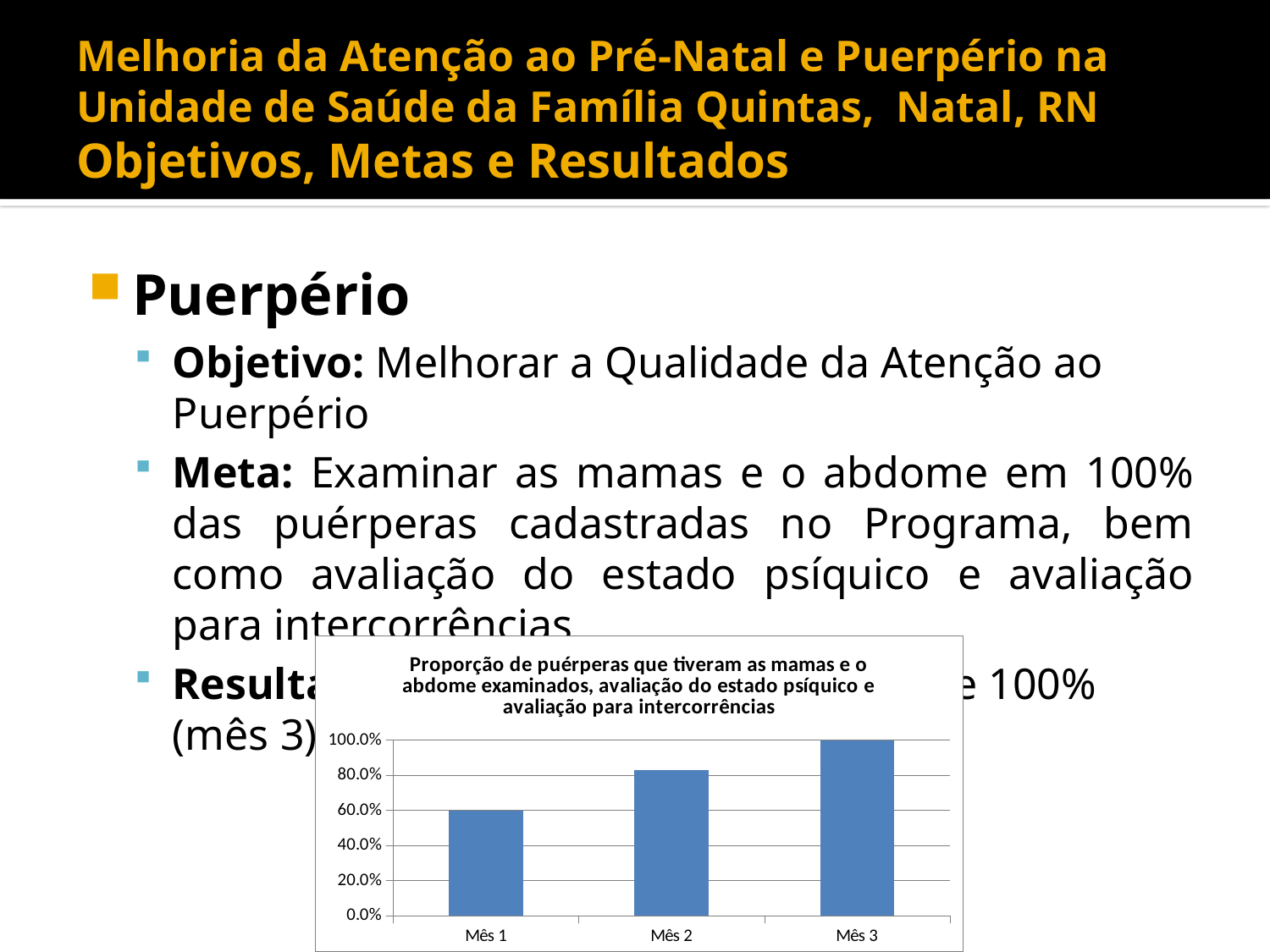
Which month has the highest proportion in the chart? Mês 3 Which is larger, the value for Mês 1 or the value for Mês 2? Mês 2 What is the value for Mês 3 in the chart? 100.0% Do the values rise or fall from Mês 1 to Mês 3? rise Is the value for Mês 2 greater or less than 100.0%? less Which month has the lowest proportion in the chart? Mês 1 How many categories (months) are plotted on the chart? 3 Is the value for Mês 1 greater or less than 80.0%? less What is the title of the chart? Proporção de puérperas que tiveram as mamas e o abdome examinados, avaliação do estado psíquico e avaliação para intercorrências Is the value for Mês 2 greater or less than 60.0%? greater What kind of chart is shown on the slide? bar chart